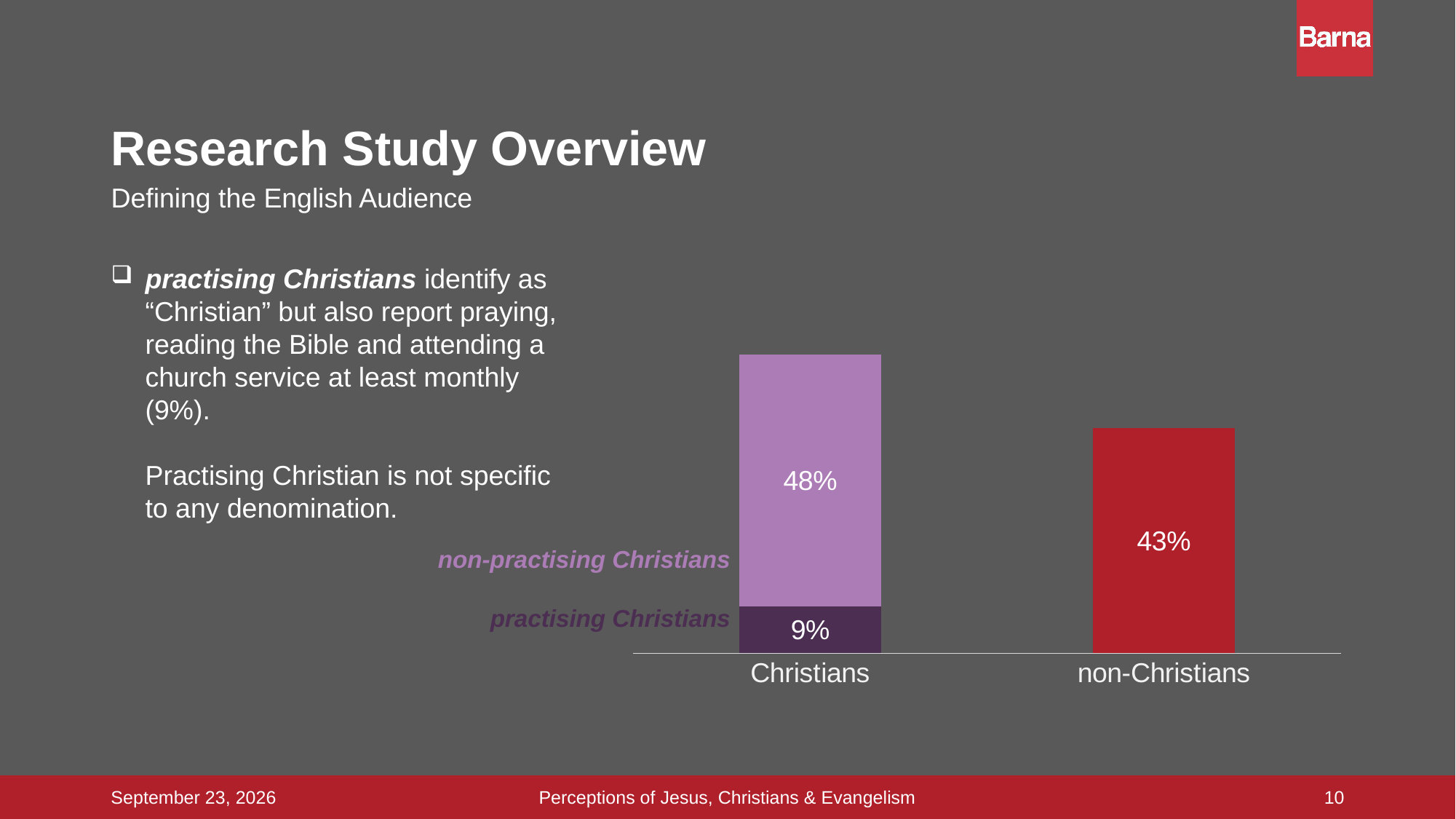
Which is larger, the non-practising Christians segment or the non-Christians bar? non-practising Christians What is the total of the stacked Christians bar? 57% How many categories are shown on the x axis? 2 What kind of chart is shown on the slide? stacked bar chart What percentage of the Christians bar is labelled as non-practising Christians? 48% What colour is the non-Christians bar? red What percentage of the Christians bar is labelled as practising Christians? 9% What value is shown for non-Christians? 43% Which segment of the Christians bar is shown in dark purple? practising Christians What is the difference between the non-practising Christians value and the practising Christians value? 39% What is the difference between the non-practising Christians value and the non-Christians value? 5% Which segment has the smallest value on the chart? practising Christians